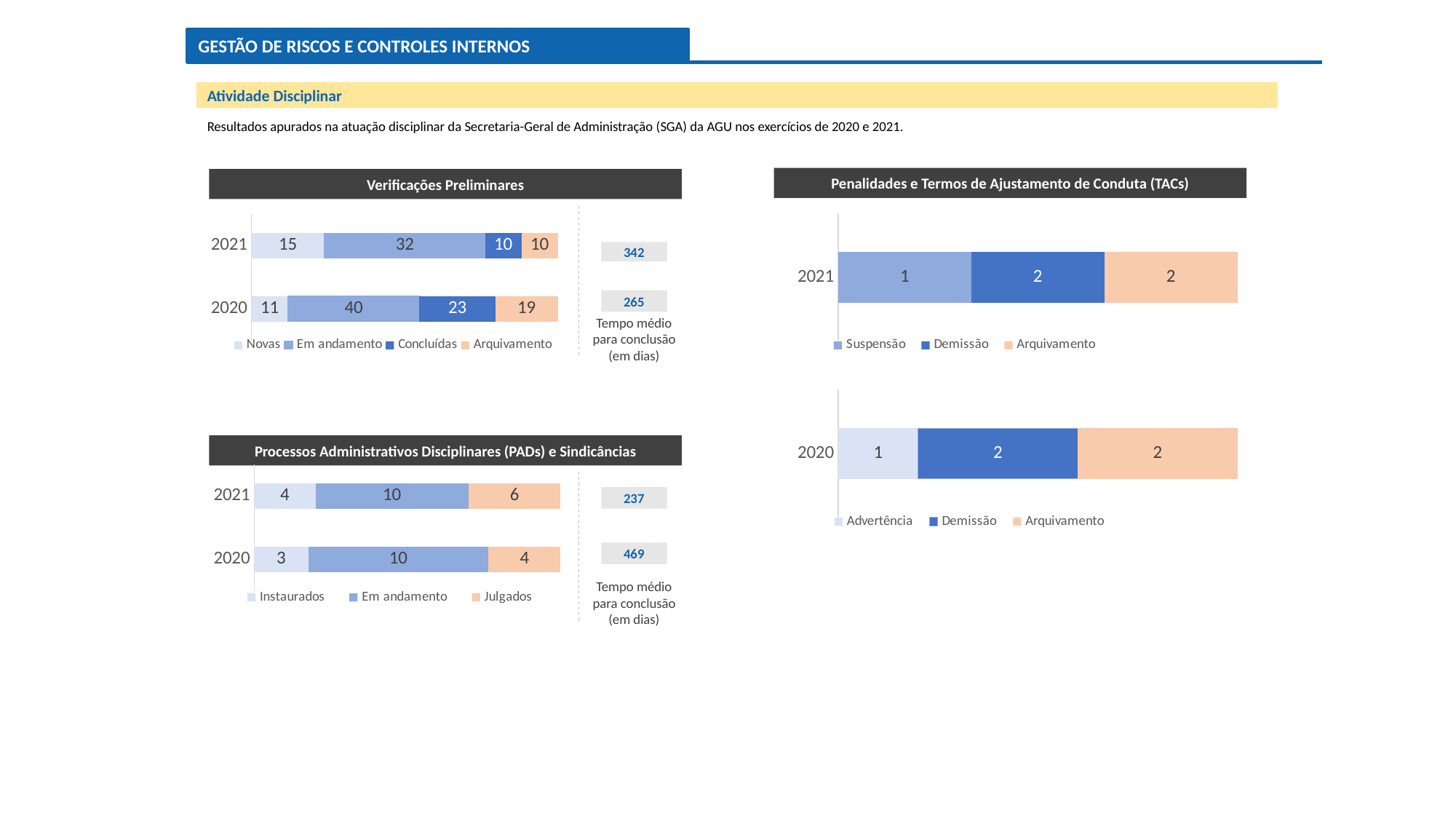
In the 'Verificações Preliminares' chart, how many series does the legend list? 4 In the 'Verificações Preliminares' chart, what is the value for 'Em andamento' in 2020? 40 In the 'Verificações Preliminares' chart, what is the difference between the 'Arquivamento' values for 2020 and 2021? 9 In the 'Processos Administrativos Disciplinares (PADs) e Sindicâncias' chart, what is the value for 'Julgados' in 2021? 6 In the 'Verificações Preliminares' chart, what is the total of the stacked bar for 2020? 93 In the 'Processos Administrativos Disciplinares (PADs) e Sindicâncias' chart, what is the total of the stacked bar for 2020? 17 In the 'Penalidades e Termos de Ajustamento de Conduta (TACs)' chart for 2020, how many series does the legend list? 3 In the 'Processos Administrativos Disciplinares (PADs) e Sindicâncias' chart, which year has the larger 'Instaurados' value, 2021 or 2020? 2021 In the 'Verificações Preliminares' chart, what is the total of the stacked bar for 2021? 67 In the 'Verificações Preliminares' chart, what is the value for 'Concluídas' in 2021? 10 What kind of chart is the 'Verificações Preliminares' chart? Stacked bar chart In the 'Penalidades e Termos de Ajustamento de Conduta (TACs)' chart for 2021, what is the value for 'Suspensão'? 1